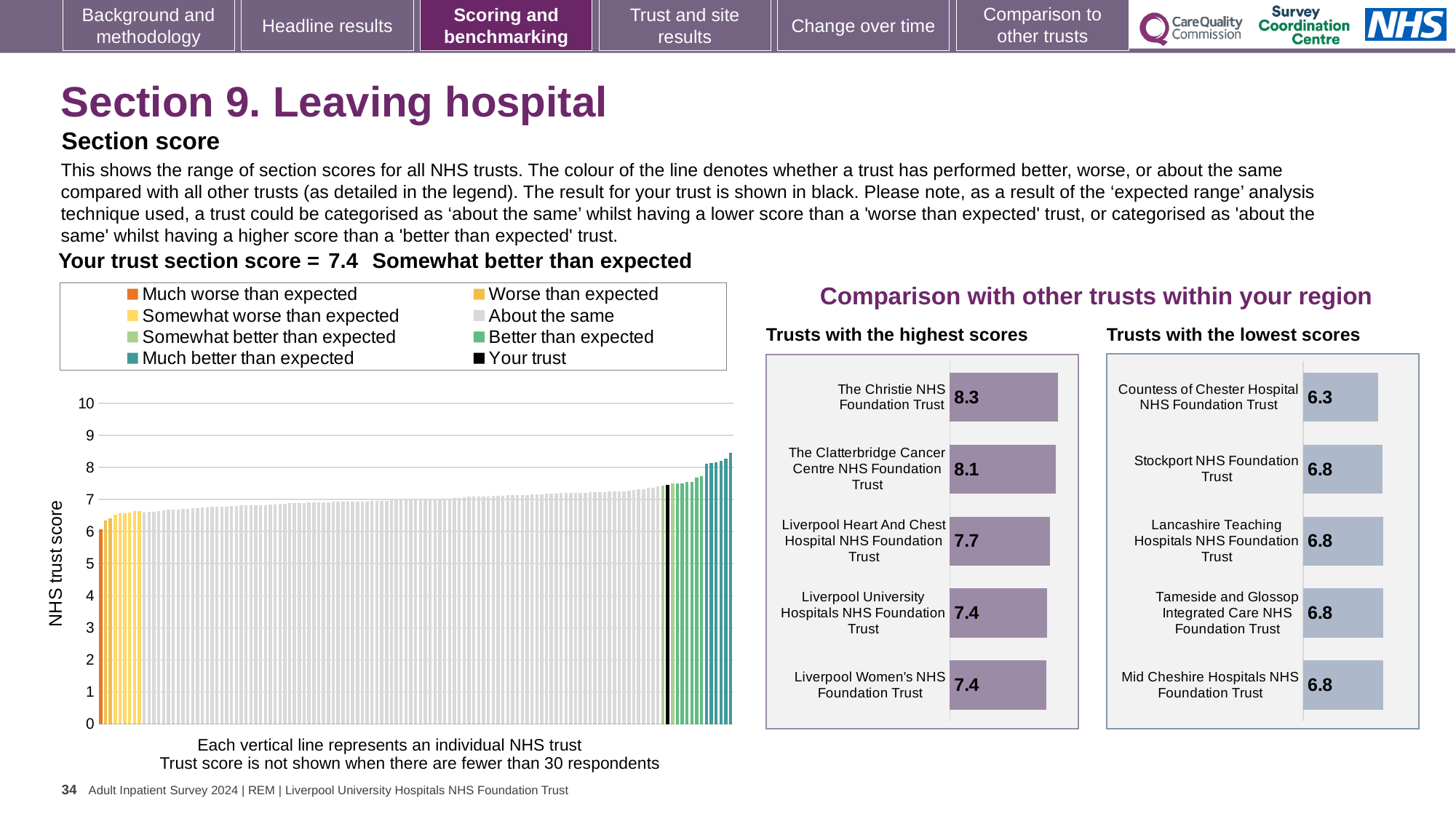
In the 'Trusts with the lowest scores' chart, what is the score for Countess of Chester Hospital NHS Foundation Trust? 6.3 In the 'Trusts with the highest scores' chart, what is the score for The Christie NHS Foundation Trust? 8.3 In the 'Trusts with the lowest scores' chart, what is the score for Stockport NHS Foundation Trust? 6.8 In the main 'NHS trust score' chart, do the bar values rise or fall from left to right? Rise What kind of chart is the main 'NHS trust score' chart on the left? Bar chart How many entries does the legend of the main 'NHS trust score' chart list? 8 In the 'Trusts with the lowest scores' chart, which trust has the lowest score? Countess of Chester Hospital NHS Foundation Trust In the 'Trusts with the highest scores' chart, which has the larger score: The Clatterbridge Cancer Centre NHS Foundation Trust or Liverpool Heart And Chest Hospital NHS Foundation Trust? The Clatterbridge Cancer Centre NHS Foundation Trust In the main 'NHS trust score' chart, what is the section score for your trust? 7.4 In the 'Trusts with the highest scores' chart, what is the difference between the scores of The Christie NHS Foundation Trust and The Clatterbridge Cancer Centre NHS Foundation Trust? 0.2 In the 'Trusts with the highest scores' chart, which trust has the highest score? The Christie NHS Foundation Trust How many trusts are shown in the 'Trusts with the lowest scores' chart? 5